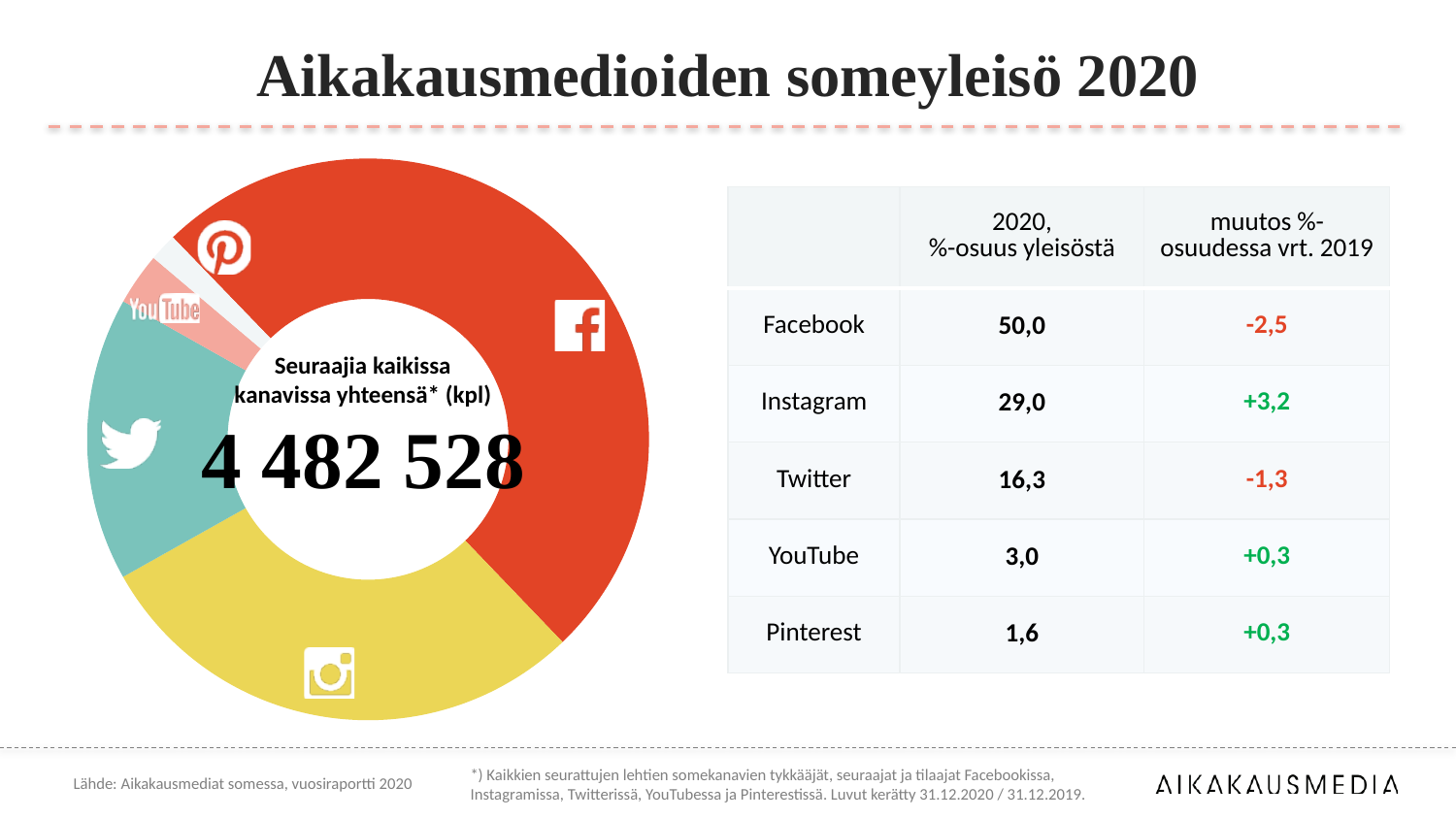
What kind of chart is shown on the left of the slide? Pie (donut) chart What is the change in Facebook's share compared with 2019, as shown in the table? -2,5 What total number of followers across all channels is printed in the centre of the donut chart? 4 482 528 How many social media channels are shown as slices in the donut chart? 5 Which has a larger share of the audience, Twitter or Instagram? Instagram Which channel has the largest slice of the donut chart? Facebook Which channel has the smallest slice of the donut chart? Pinterest By how many percentage points does Facebook's share exceed Instagram's share in 2020? 21,0 What share of the 2020 audience does Instagram account for, according to the table? 29,0 What is the change in Instagram's share compared with 2019, as shown in the table? +3,2 What is the title of the slide? Aikakausmedioiden someyleisö 2020 What share of the 2020 audience does Facebook account for, according to the table? 50,0